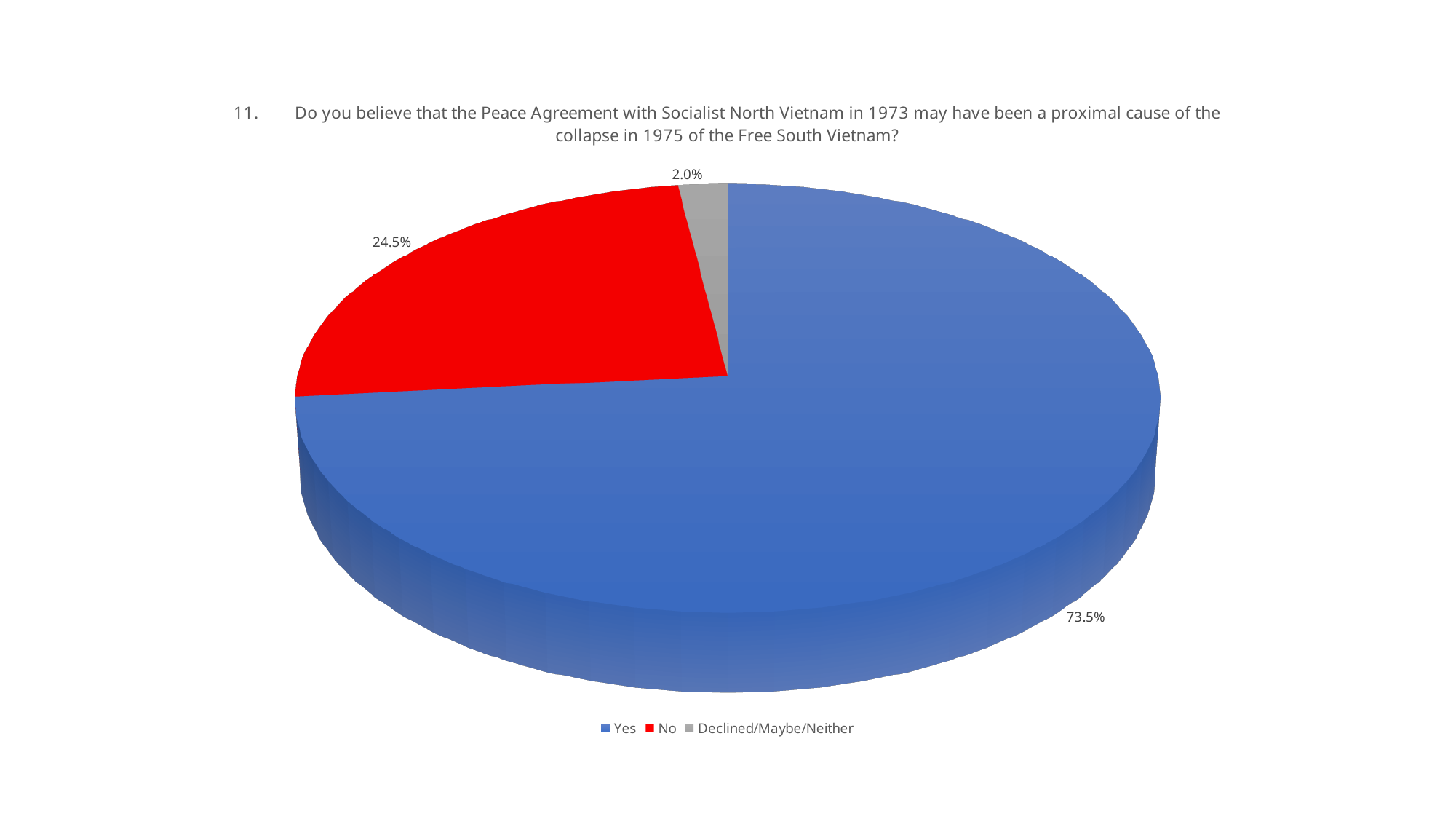
What percentage of respondents are in the Declined/Maybe/Neither category? 2.0% What percentage of respondents answered No? 24.5% Which response has the largest share of the pie? Yes What share of the pie does the No slice represent? 24.5% How many categories does the pie chart show? 3 What is the combined share of the No and Declined/Maybe/Neither slices? 26.5% Which is larger, the share for No or the share for Declined/Maybe/Neither? No What kind of chart is shown on the slide? Pie chart What percentage of respondents answered Yes? 73.5% Which response has the smallest share of the pie? Declined/Maybe/Neither What is the difference in percentage points between the Yes and No shares? 49.0 percentage points What colour is the Yes slice? Blue